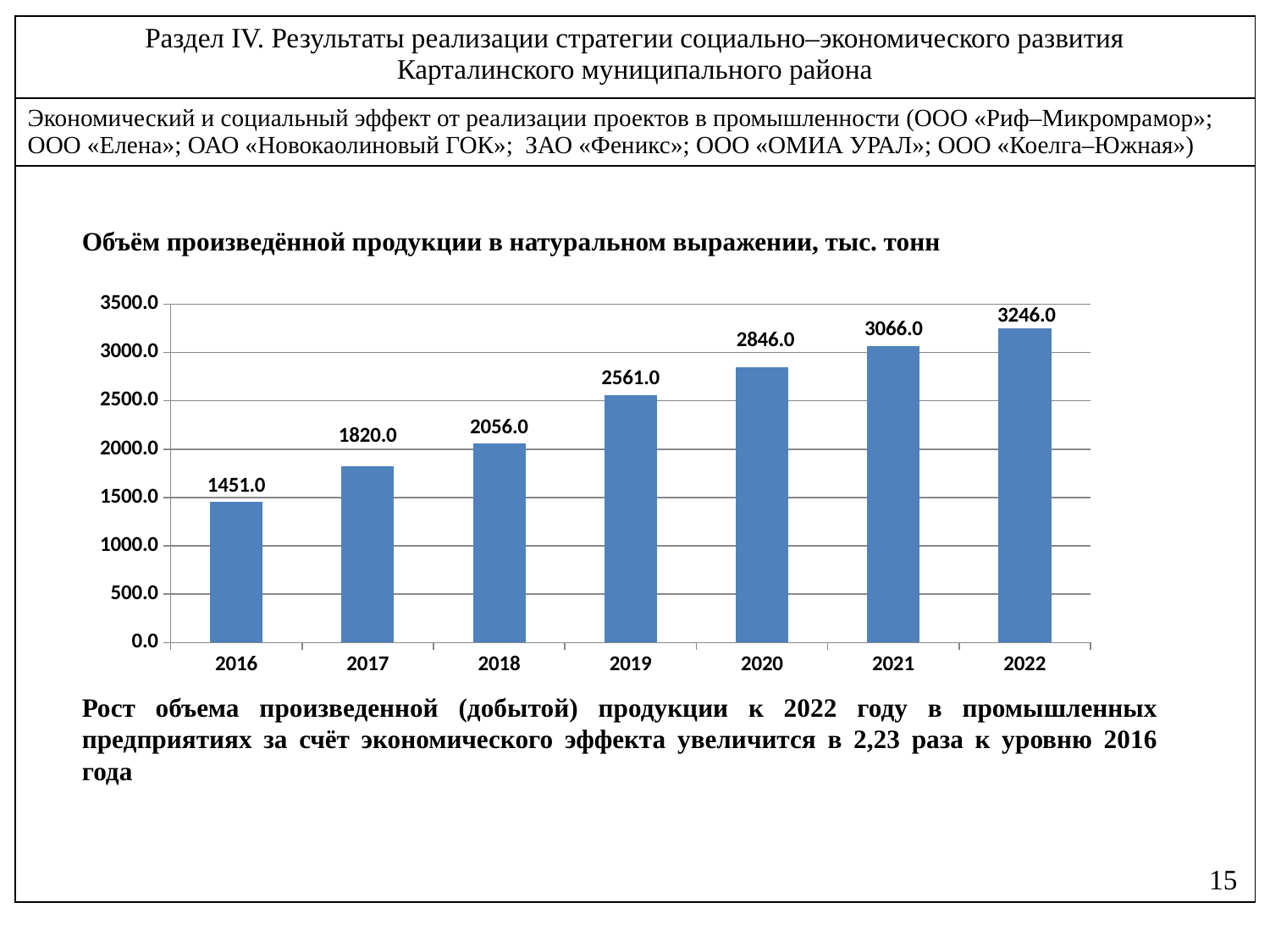
How many years are shown on the x axis? 7 What is the difference between the values for 2021 and 2020? 220.0 Is the value for 2020 greater or less than 2500.0? greater What is the difference between the values for 2022 and 2016? 1795.0 What is the value for 2022? 3246.0 What kind of chart is shown? bar chart Which year has the lowest value? 2016 What is the value for 2016? 1451.0 Which year has the highest value? 2022 Which is larger, the value for 2018 or the value for 2017? 2018 What is the value for 2019? 2561.0 Do the values rise or fall from 2016 to 2022? rise